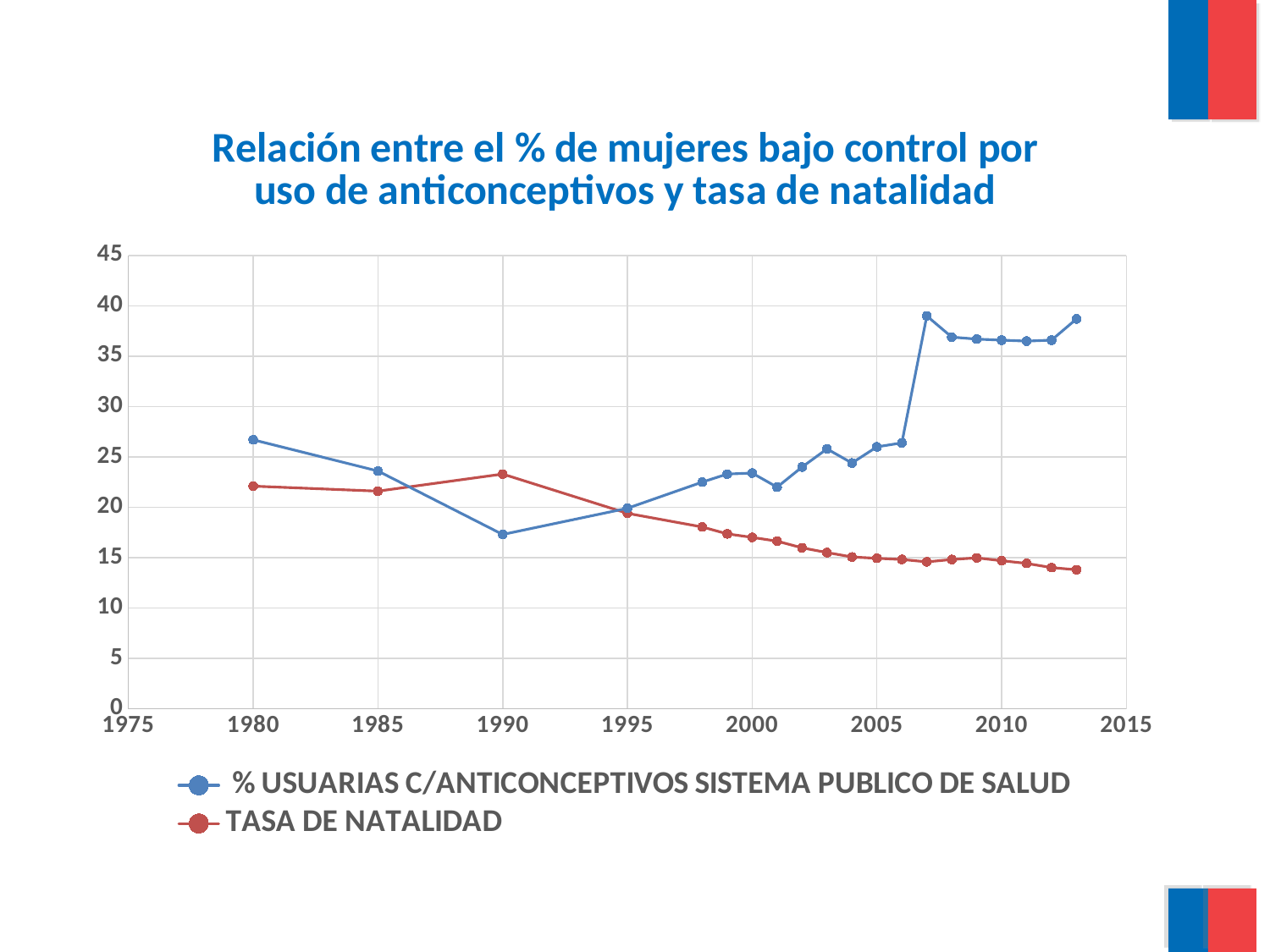
Is the value for TASA DE NATALIDAD in 2013 greater or less than 15? less What is the title of the chart? Relación entre el % de mujeres bajo control por uso de anticonceptivos y tasa de natalidad How many series does the legend list? 2 Is the value for % USUARIAS C/ANTICONCEPTIVOS SISTEMA PUBLICO DE SALUD in 2007 greater or less than 35? greater In which year is the % USUARIAS C/ANTICONCEPTIVOS SISTEMA PUBLICO DE SALUD series at its lowest? 1990 Which series is drawn in red? TASA DE NATALIDAD Does the TASA DE NATALIDAD series rise or fall from 1995 to 2013? fall In 2010, which series has the higher value, % USUARIAS C/ANTICONCEPTIVOS SISTEMA PUBLICO DE SALUD or TASA DE NATALIDAD? % USUARIAS C/ANTICONCEPTIVOS SISTEMA PUBLICO DE SALUD In 1990, which series has the higher value, % USUARIAS C/ANTICONCEPTIVOS SISTEMA PUBLICO DE SALUD or TASA DE NATALIDAD? TASA DE NATALIDAD Is the value for % USUARIAS C/ANTICONCEPTIVOS SISTEMA PUBLICO DE SALUD in 1990 greater or less than 20? less What kind of chart is shown on the slide? line chart In which year is the TASA DE NATALIDAD series at its highest? 1990